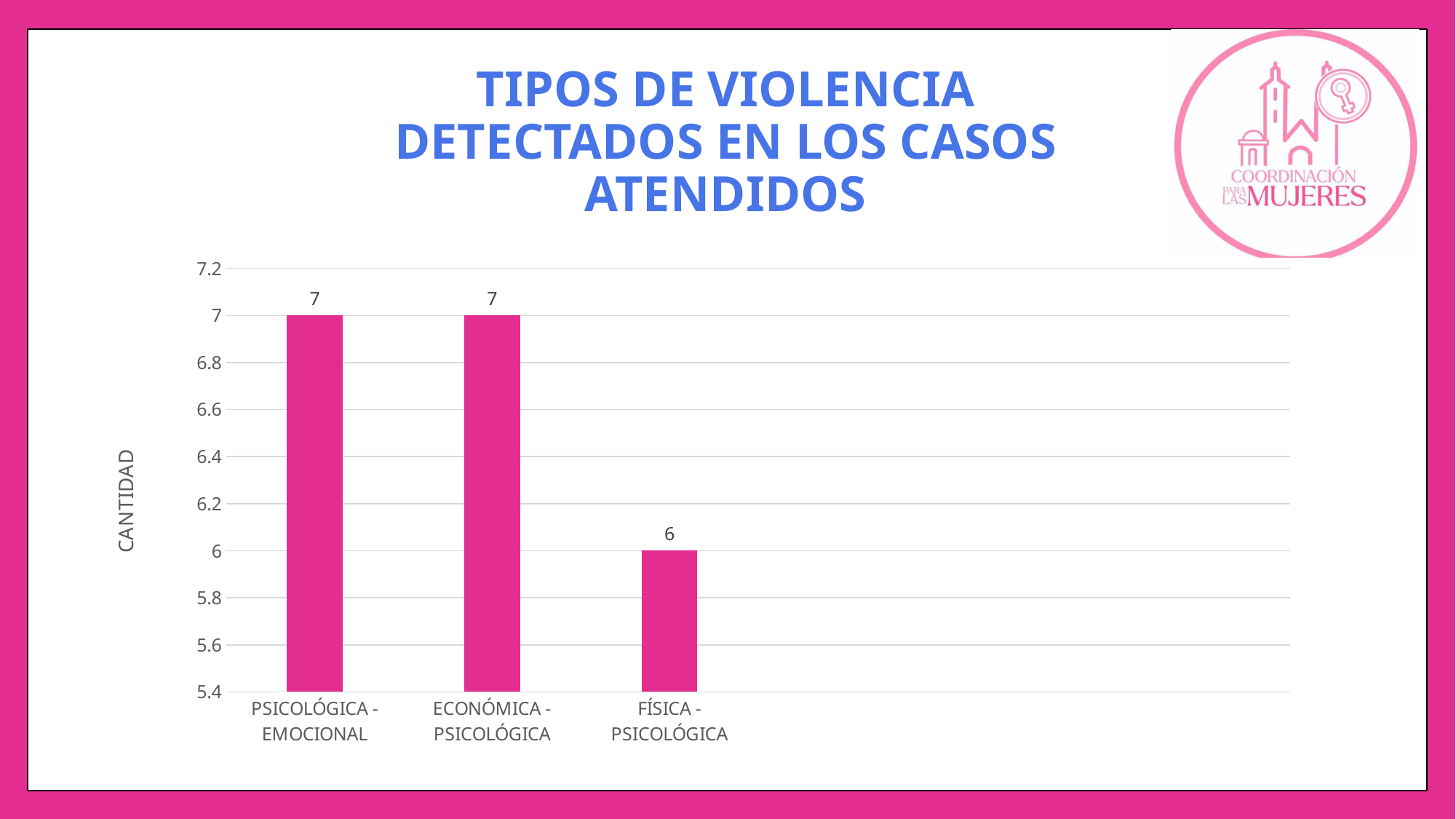
Is the value for FÍSICA - PSICOLÓGICA greater or less than 6.4? less What is the value for ECONÓMICA - PSICOLÓGICA? 7 What is the value for FÍSICA - PSICOLÓGICA? 6 What kind of chart is shown on the slide? bar chart Which is larger, the value for ECONÓMICA - PSICOLÓGICA or the value for FÍSICA - PSICOLÓGICA? ECONÓMICA - PSICOLÓGICA What is the difference between the values for PSICOLÓGICA - EMOCIONAL and FÍSICA - PSICOLÓGICA? 1 What is the label of the vertical axis? CANTIDAD How many categories are shown on the x axis? 3 What is the title of the chart? TIPOS DE VIOLENCIA DETECTADOS EN LOS CASOS ATENDIDOS Which category has the lowest value? FÍSICA - PSICOLÓGICA What is the total of the three values shown? 20 What is the value for PSICOLÓGICA - EMOCIONAL? 7